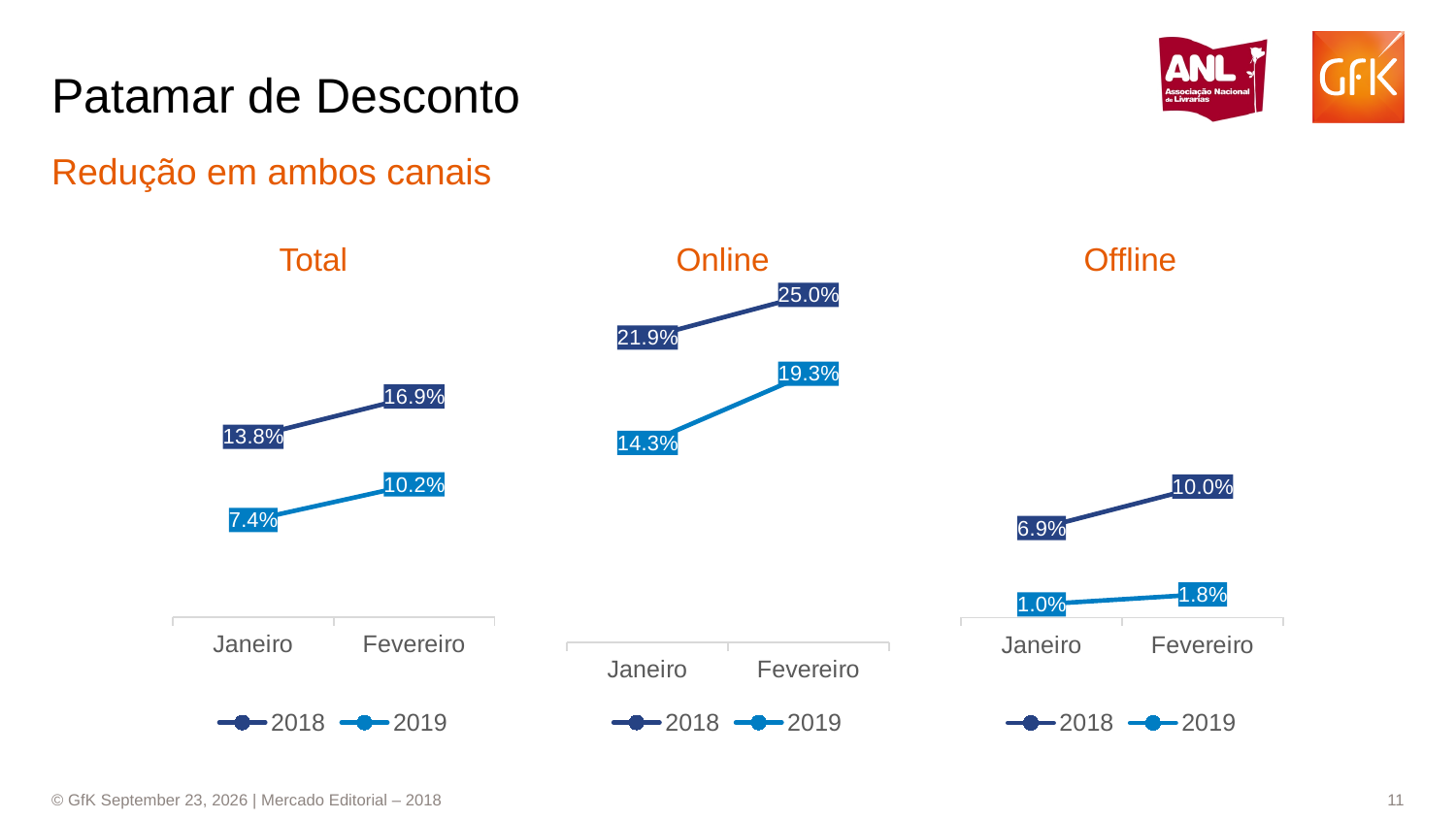
In the Offline chart, what is the value for 2019 in Janeiro? 1.0% In the Online chart, what is the value for 2018 in Janeiro? 21.9% In the Total chart, how much did the 2018 value increase from Janeiro to Fevereiro? 3.1% Which of the three charts has the highest plotted value on the slide? Online What type of chart is the Online chart? line chart How many series does the legend of the Total chart list? 2 In the Offline chart, what is the value for 2018 in Fevereiro? 10.0% In the Online chart, does the 2019 series rise or fall from Janeiro to Fevereiro? rise In the Offline chart, which series has the higher value in Janeiro, 2018 or 2019? 2018 In the Online chart, what is the difference between the 2018 and 2019 values in Fevereiro? 5.7% In the Total chart, what is the value for 2019 in Fevereiro? 10.2% How many categories are shown on the x axis of the Offline chart? 2